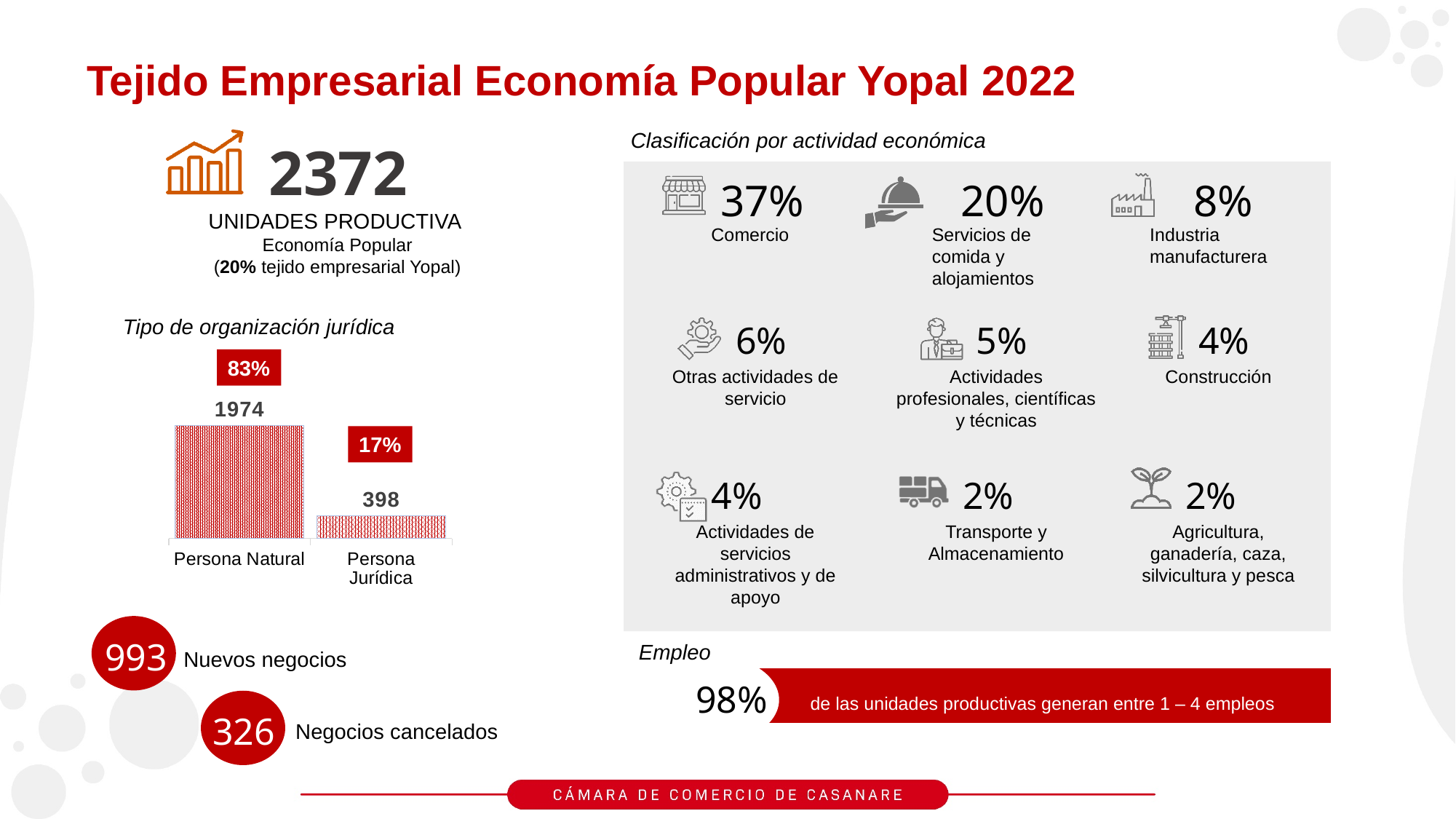
In the 'Tipo de organización jurídica' chart, what is the difference between the values for Persona Natural and Persona Jurídica? 1576 In the 'Tipo de organización jurídica' chart, what is the value for Persona Jurídica? 398 In the 'Tipo de organización jurídica' chart, what percentage is shown above the Persona Natural bar? 83% In the 'Tipo de organización jurídica' chart, which category has the highest value? Persona Natural What kind of chart is the 'Tipo de organización jurídica' chart? Bar chart In the 'Tipo de organización jurídica' chart, what is the sum of the values for Persona Natural and Persona Jurídica? 2372 In the 'Tipo de organización jurídica' chart, what percentage is shown above the Persona Jurídica bar? 17% In the 'Tipo de organización jurídica' chart, what is the value for Persona Natural? 1974 In the 'Tipo de organización jurídica' chart, which is larger, Persona Natural or Persona Jurídica? Persona Natural In the 'Tipo de organización jurídica' chart, which category has the lowest value? Persona Jurídica How many categories does the 'Tipo de organización jurídica' chart show? 2 What is the title of the bar chart on the left side of the slide? Tipo de organización jurídica